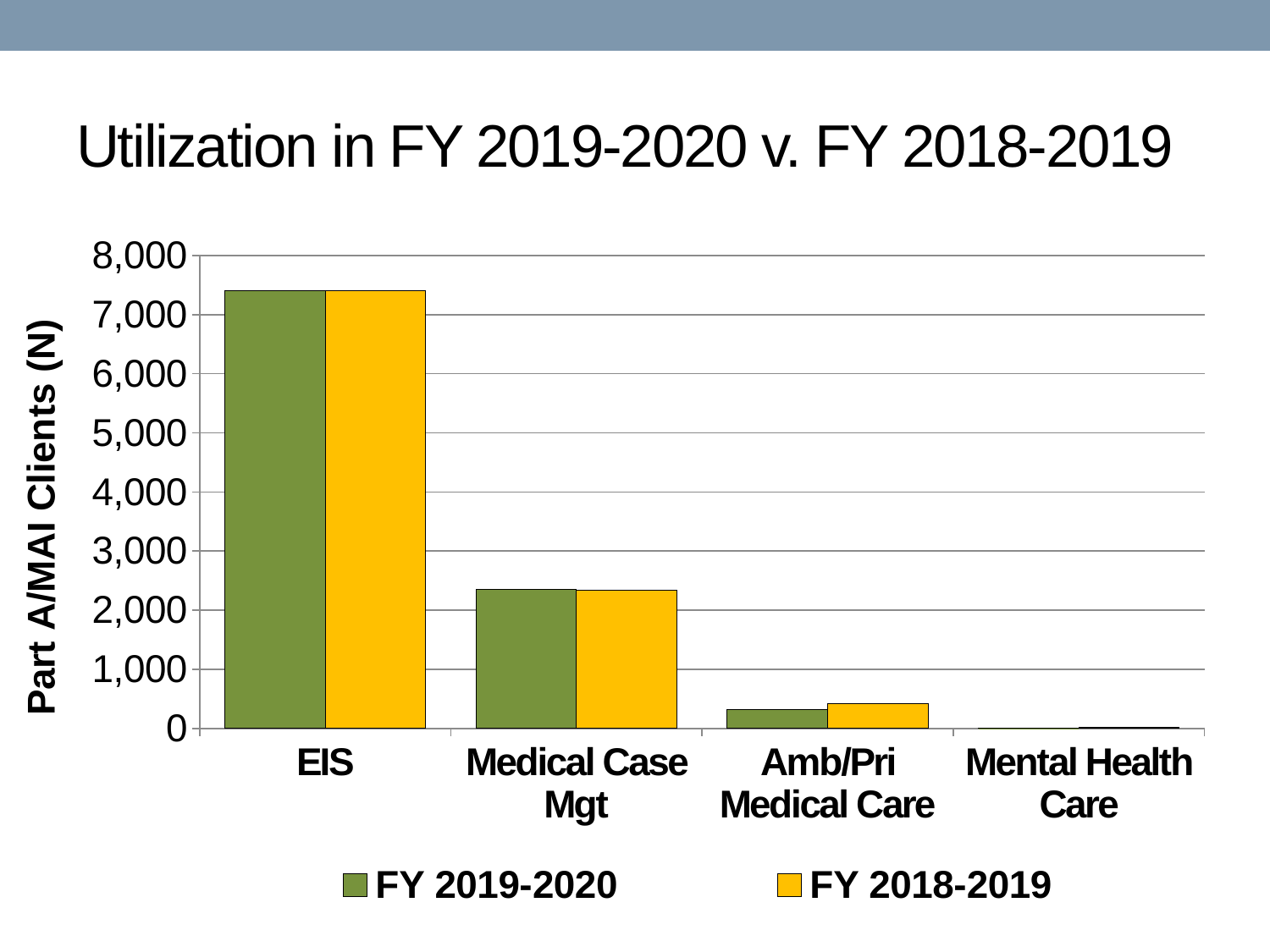
Is the FY 2018-2019 value for Medical Case Mgt greater or less than 3,000? less Is the FY 2018-2019 value for Amb/Pri Medical Care greater or less than 1,000? less How many categories are shown on the x axis? 4 For Amb/Pri Medical Care, which series has the larger value, FY 2019-2020 or FY 2018-2019? FY 2018-2019 Is the FY 2019-2020 value for EIS greater or less than 7,000? greater What is the title of the chart? Utilization in FY 2019-2020 v. FY 2018-2019 Which category has the highest number of Part A/MAI clients? EIS How many series does the legend list? 2 What kind of chart is shown on the slide? bar chart What is the label on the y axis? Part A/MAI Clients (N) Which category has the lowest number of Part A/MAI clients? Mental Health Care